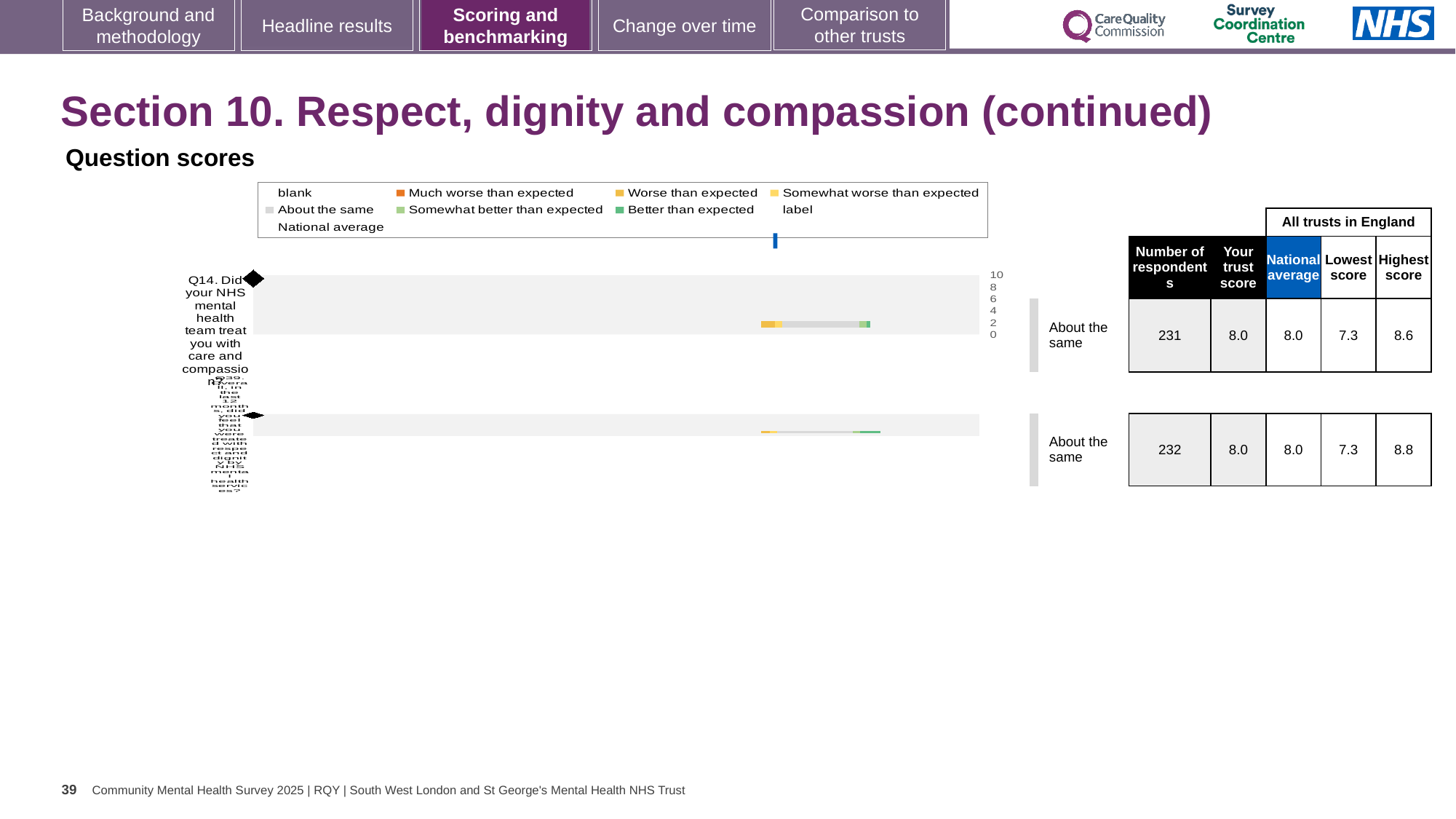
In the table beside the chart, what is the number of respondents for Q39? 232 What benchmark category is shown next to the chart for Q14? About the same What is the highest value shown on the chart's numeric axis? 10 How many questions (rows) are plotted in the chart? 2 In the table beside the chart, what is the number of respondents for Q14? 231 In the table beside the chart, what is the lowest score across all trusts in England for Q14? 7.3 In the table beside the chart, what is the trust score for Q14? 8.0 Which legend entry is shown in dark orange? Much worse than expected In the table beside the chart, what is the highest score across all trusts in England for Q39? 8.8 Which question has the larger highest score in the table, Q14 or Q39? Q39 What is the difference between the highest scores for Q39 and Q14 in the table? 0.2 What kind of chart is shown under 'Question scores'? bar chart